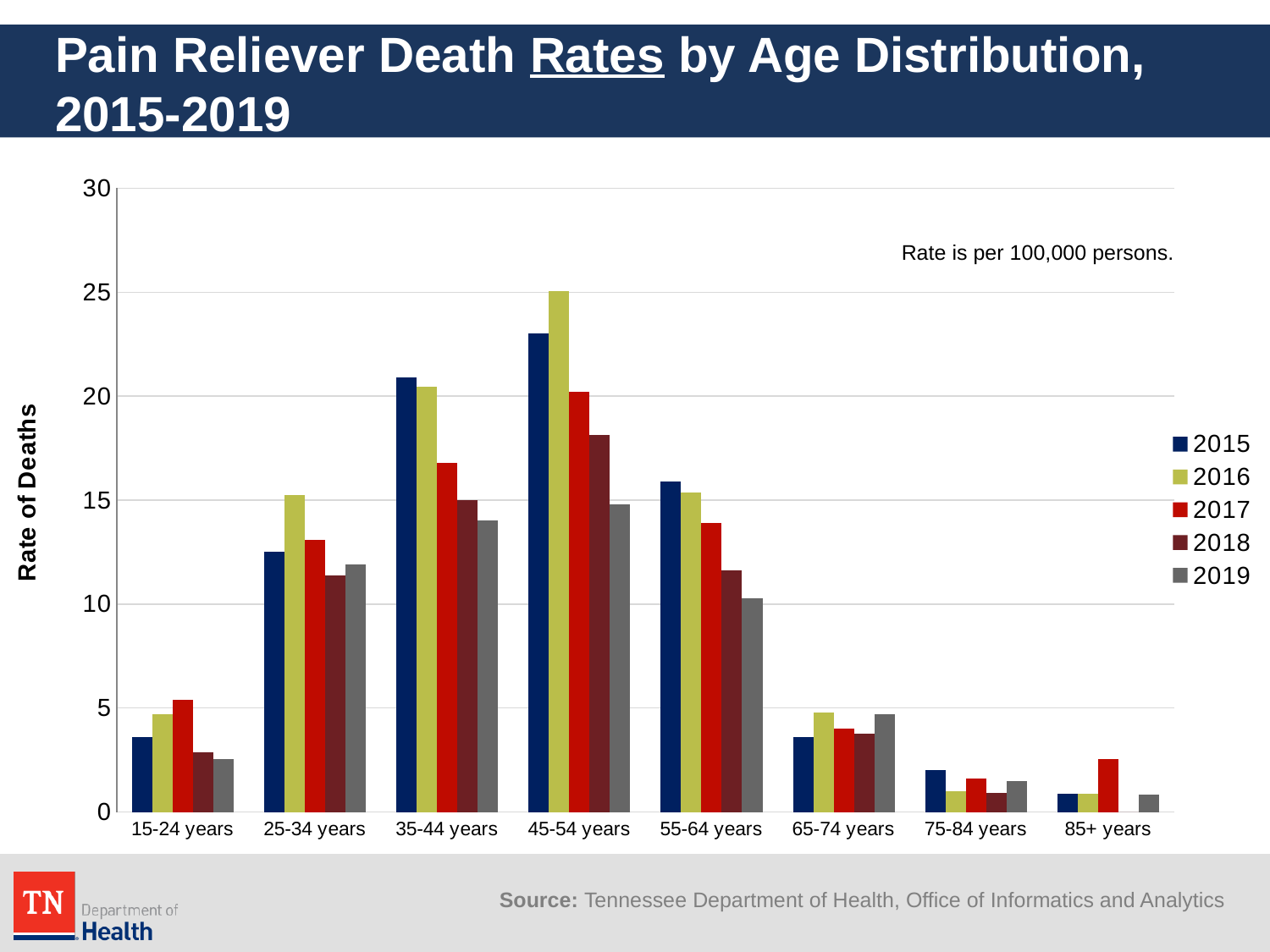
Which age group has the highest 2016 bar? 45-54 years Is the 2015 value for 25-34 years greater or less than 10? greater Is the 2019 value for 55-64 years greater or less than 15? less How many series does the legend list? 5 What kind of chart is shown on the slide? bar chart Which age group has the lowest 2015 bar? 85+ years How many age groups are shown on the x axis? 8 For 35-44 years, which is larger: the 2015 value or the 2019 value? 2015 For 55-64 years, do the values rise or fall from 2015 to 2019? fall Is the 2016 value for 45-54 years greater or less than 20? greater Which is larger: the 2017 value for 15-24 years or the 2017 value for 65-74 years? 15-24 years What is the title of the y axis? Rate of Deaths